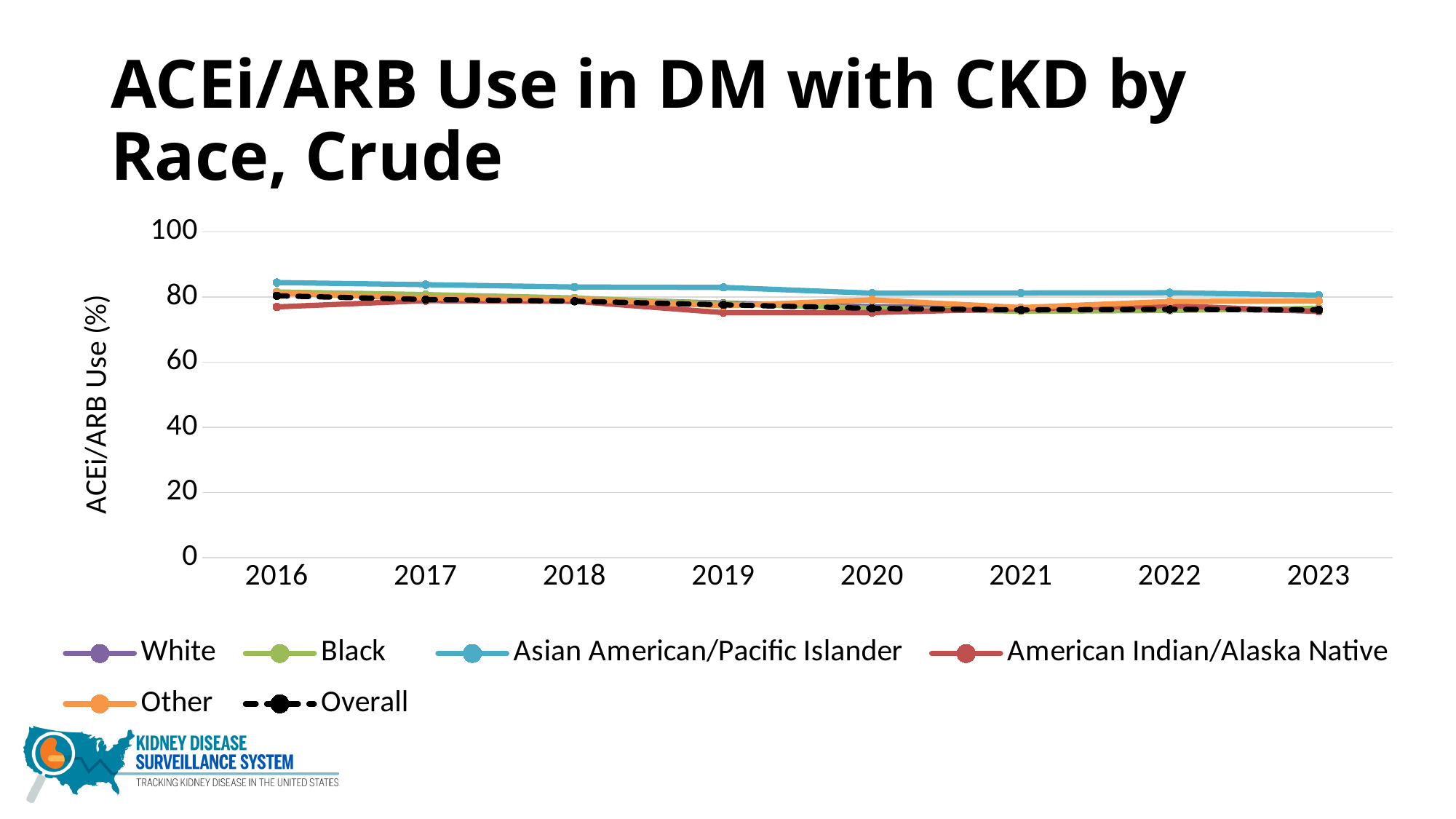
Does the Asian American/Pacific Islander line rise or fall from 2016 to 2023? fall Is the value for American Indian/Alaska Native in 2019 greater or less than 80? less Is the value for Asian American/Pacific Islander in 2016 greater or less than 80? greater Is the value for Overall in 2023 greater or less than 80? less Which series is drawn with a dashed line? Overall Which series has the highest ACEi/ARB use in 2016? Asian American/Pacific Islander How many years are plotted along the x axis? 8 Which is larger in 2020, the value for Asian American/Pacific Islander or the value for American Indian/Alaska Native? Asian American/Pacific Islander What kind of chart is shown on the slide? line chart Which series has the lowest ACEi/ARB use in 2019? American Indian/Alaska Native How many series does the legend list? 6